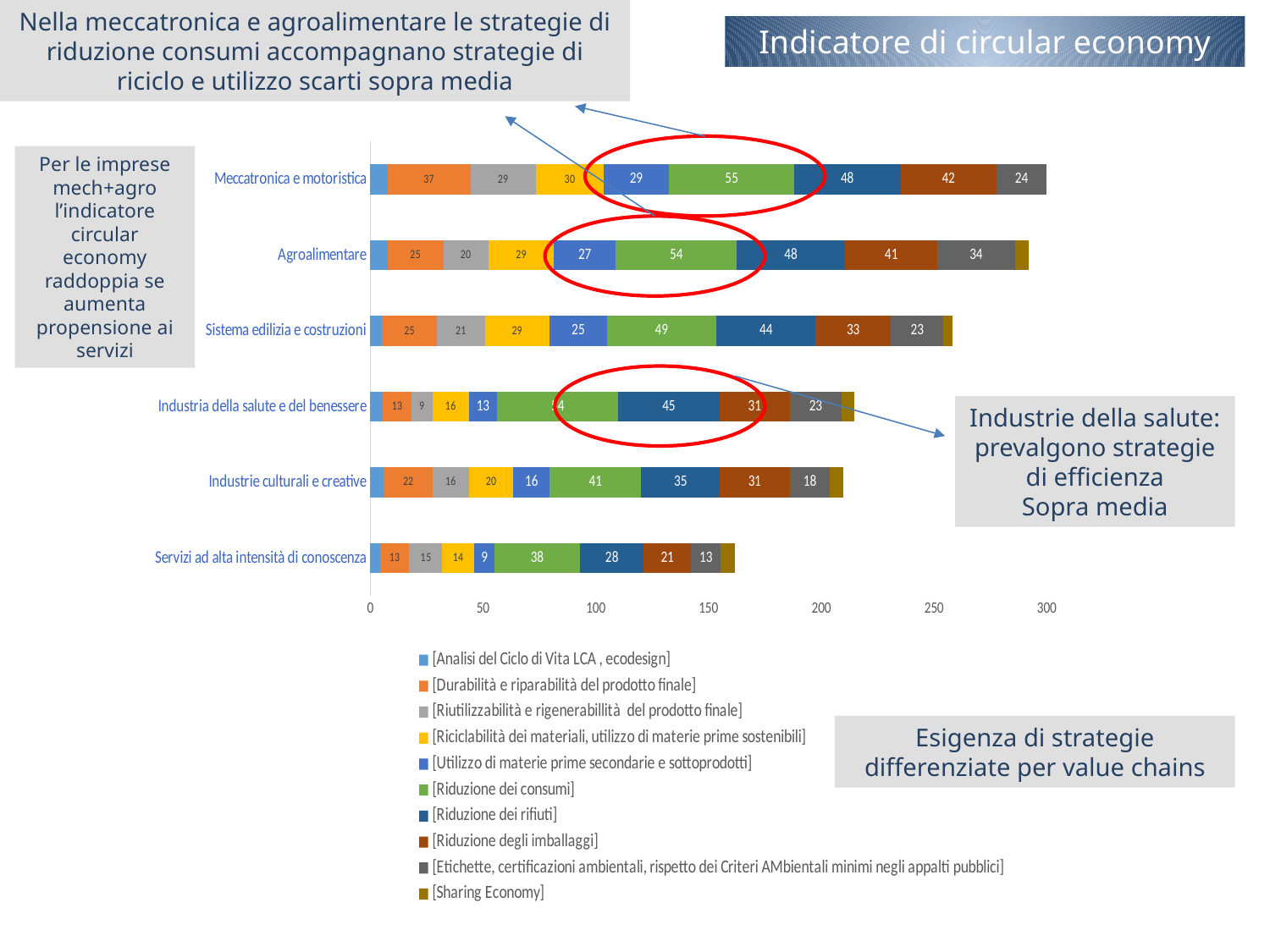
What is the value of 'Riduzione dei consumi' for Servizi ad alta intensità di conoscenza? 38 What is the difference between the 'Riduzione dei consumi' values for Meccatronica e motoristica and Industrie culturali e creative? 14 Which category has the highest value for 'Riduzione dei consumi'? Meccatronica e motoristica What is the value of 'Riduzione dei consumi' for Meccatronica e motoristica? 55 How many categories (value chains) are plotted on the chart? 6 How many series does the chart legend list? 10 What is the value of 'Riduzione dei rifiuti' for Agroalimentare? 48 Which category has the lowest value for 'Riduzione dei rifiuti'? Servizi ad alta intensità di conoscenza What is the value of 'Riduzione degli imballaggi' for Sistema edilizia e costruzioni? 33 What type of chart is shown on the slide? Stacked bar chart Is the total bar length for Servizi ad alta intensità di conoscenza greater or less than 150? greater Which is larger: 'Durabilità e riparabilità del prodotto finale' for Meccatronica e motoristica or for Agroalimentare? Meccatronica e motoristica